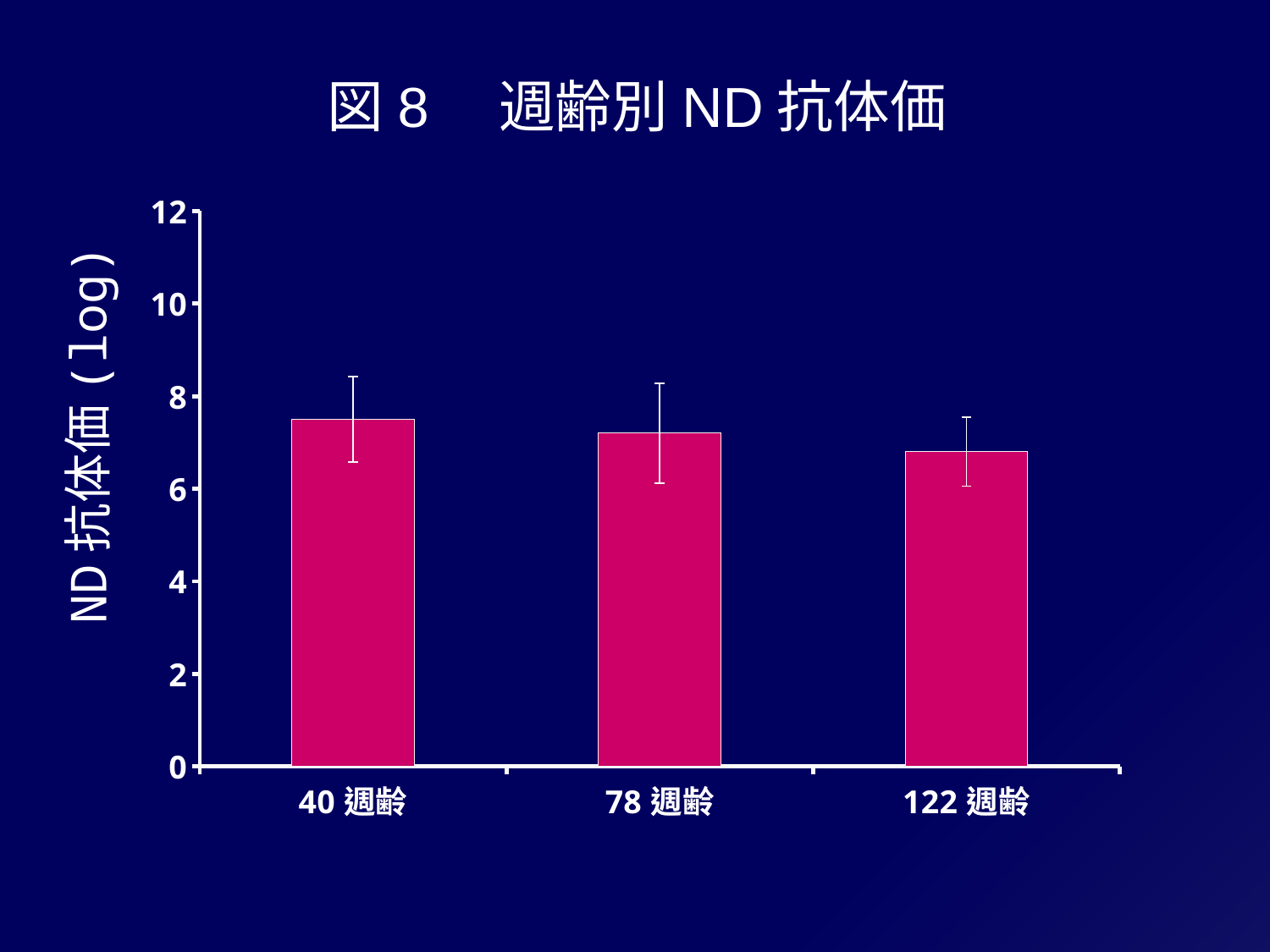
Is the value for 40 週齢 greater or less than 8? less What kind of chart is shown on the slide? bar chart How many age groups (categories) are plotted on the x axis? 3 Which age group has the highest ND antibody titer? 40 週齢 Which age group has the lowest ND antibody titer? 122 週齢 What is the maximum value shown on the y axis? 12 Which is larger, the value for 40 週齢 or the value for 122 週齢? 40 週齢 What is the title of the chart? 図 8 週齢別 ND 抗体価 Is the value for 122 週齢 greater or less than 6? greater What is the label of the y axis? ND 抗体価 (log) Is the value for 78 週齢 greater or less than 6? greater Do the bar values rise or fall as the age in weeks increases along the x axis? fall